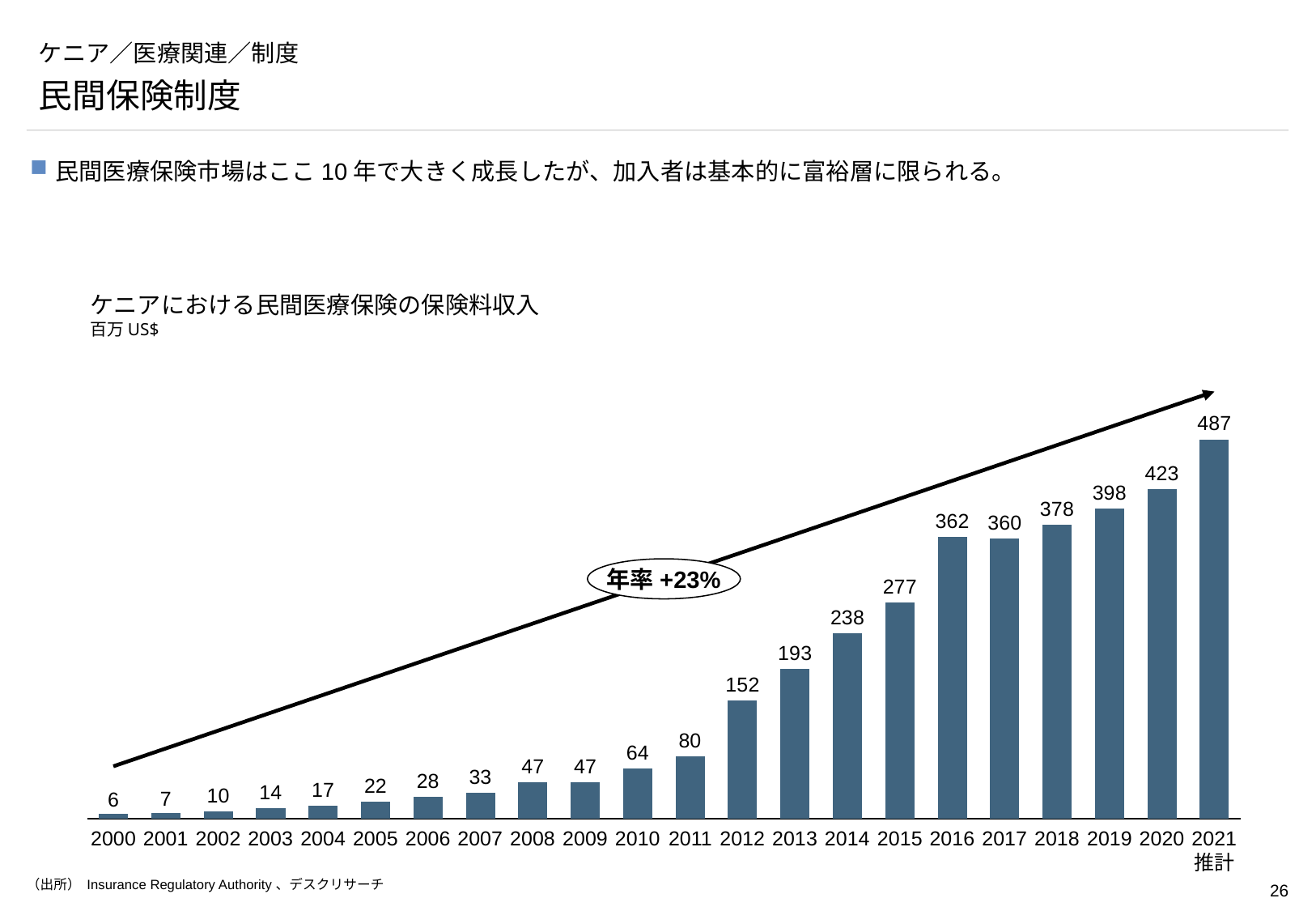
How many years are shown on the x axis? 22 What is the value for 2000? 6 Which is larger, the value for 2016 or the value for 2017? 2016 What type of chart is shown on the slide? bar chart What is the value for 2012? 152 Do the values generally rise or fall from 2000 to 2021? rise What is the value for 2021 (推計)? 487 What is the difference between the values for 2020 and 2019? 25 Which year has the highest value? 2021 What annual growth rate is shown in the annotation on the chart? 年率 +23% Which year has the lowest value? 2000 What unit is stated under the chart title? 百万 US$